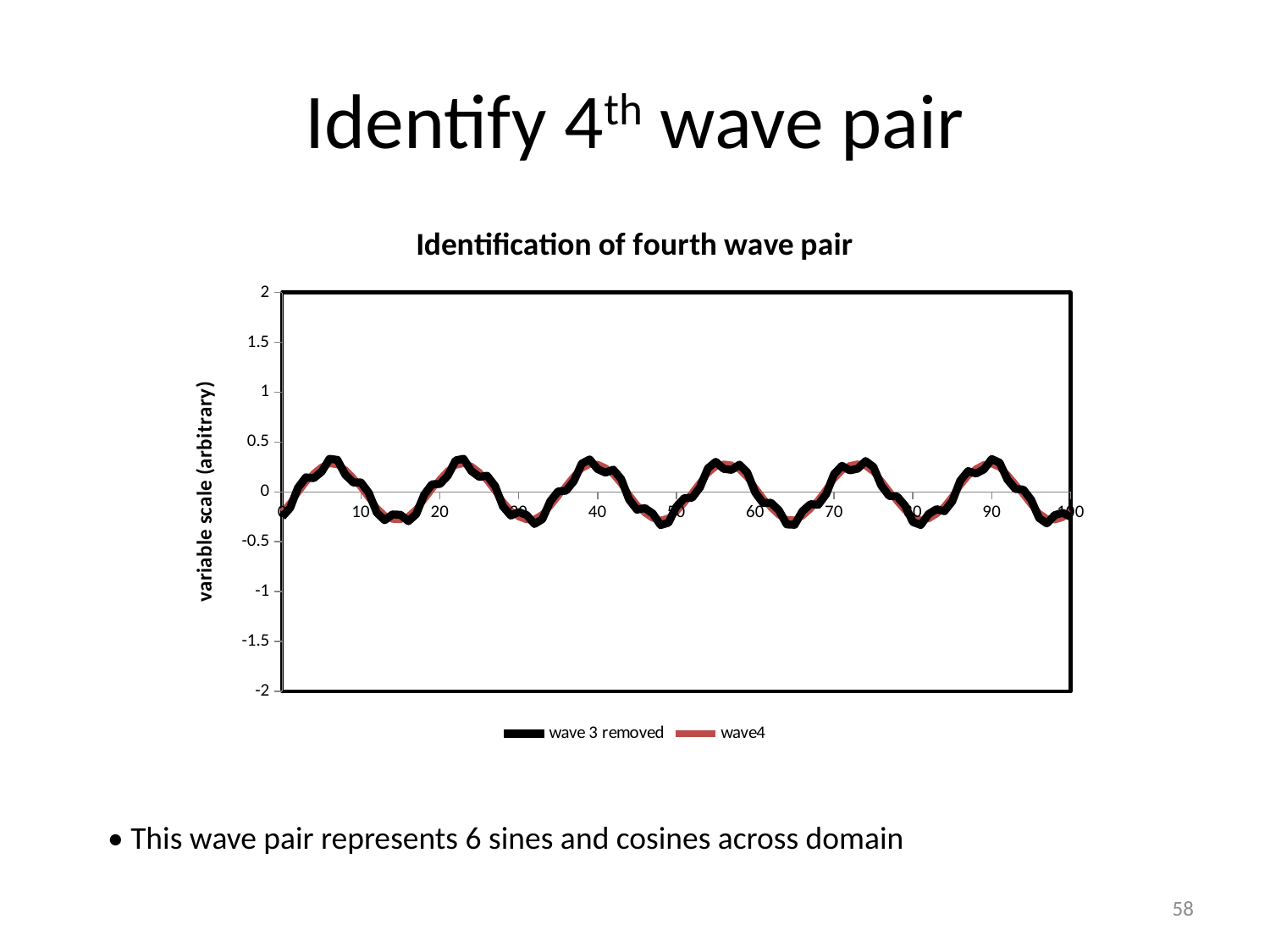
What is the label on the vertical axis of the chart? variable scale (arbitrary) Is the value of the wave 3 removed series at x = 40 greater or less than 0? greater Is the lowest value reached by the wave4 series greater or less than -0.5? greater Is the highest value reached by the wave 3 removed series greater or less than 1? less How many peaks does the wave4 series show across the domain from 0 to 100? 6 What is the title of the chart? Identification of fourth wave pair How many series does the legend of the chart list? 2 What kind of chart is shown on the slide? line chart Does the wave4 series show a steady rise, a steady fall, or an oscillation along the x axis? oscillation